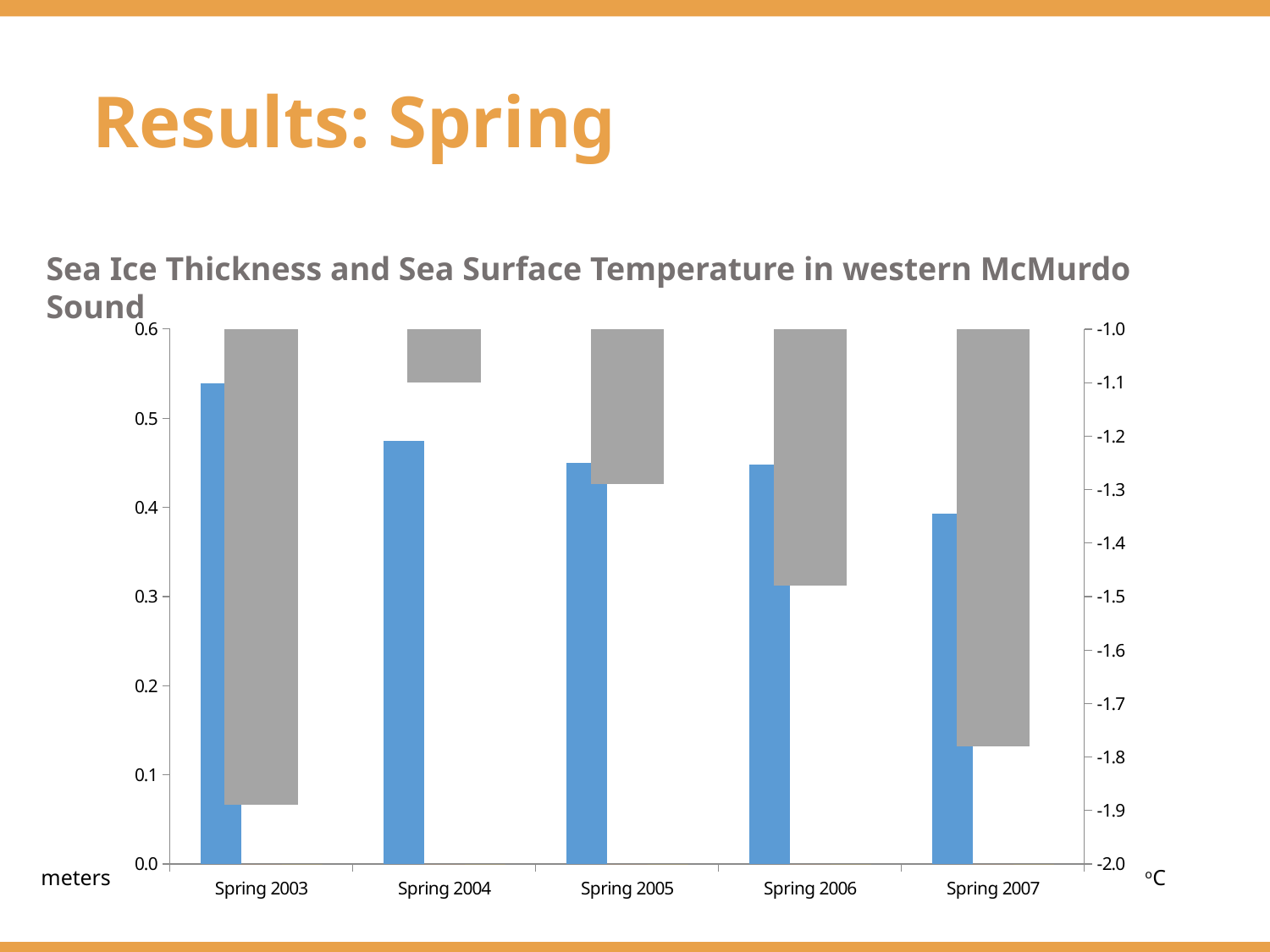
Which spring has the gray bar (sea surface temperature) that extends furthest down the right axis? Spring 2003 Is the blue bar (sea ice thickness) for Spring 2004 greater or less than 0.5 meters? less Is the blue bar (sea ice thickness) for Spring 2003 greater or less than 0.5 meters? greater How many spring seasons (categories) are shown on the x axis? 5 Which spring has the tallest blue bar (sea ice thickness)? Spring 2003 What unit is labelled on the left axis of the chart? meters Do the blue bars (sea ice thickness) generally rise or fall from Spring 2003 to Spring 2007? fall Which spring has the shortest blue bar (sea ice thickness)? Spring 2007 Which blue bar is taller, Spring 2003 or Spring 2007? Spring 2003 What kind of chart is shown on the slide? bar chart Is the gray bar (sea surface temperature) for Spring 2004 greater or less than -1.5 °C on the right axis? greater